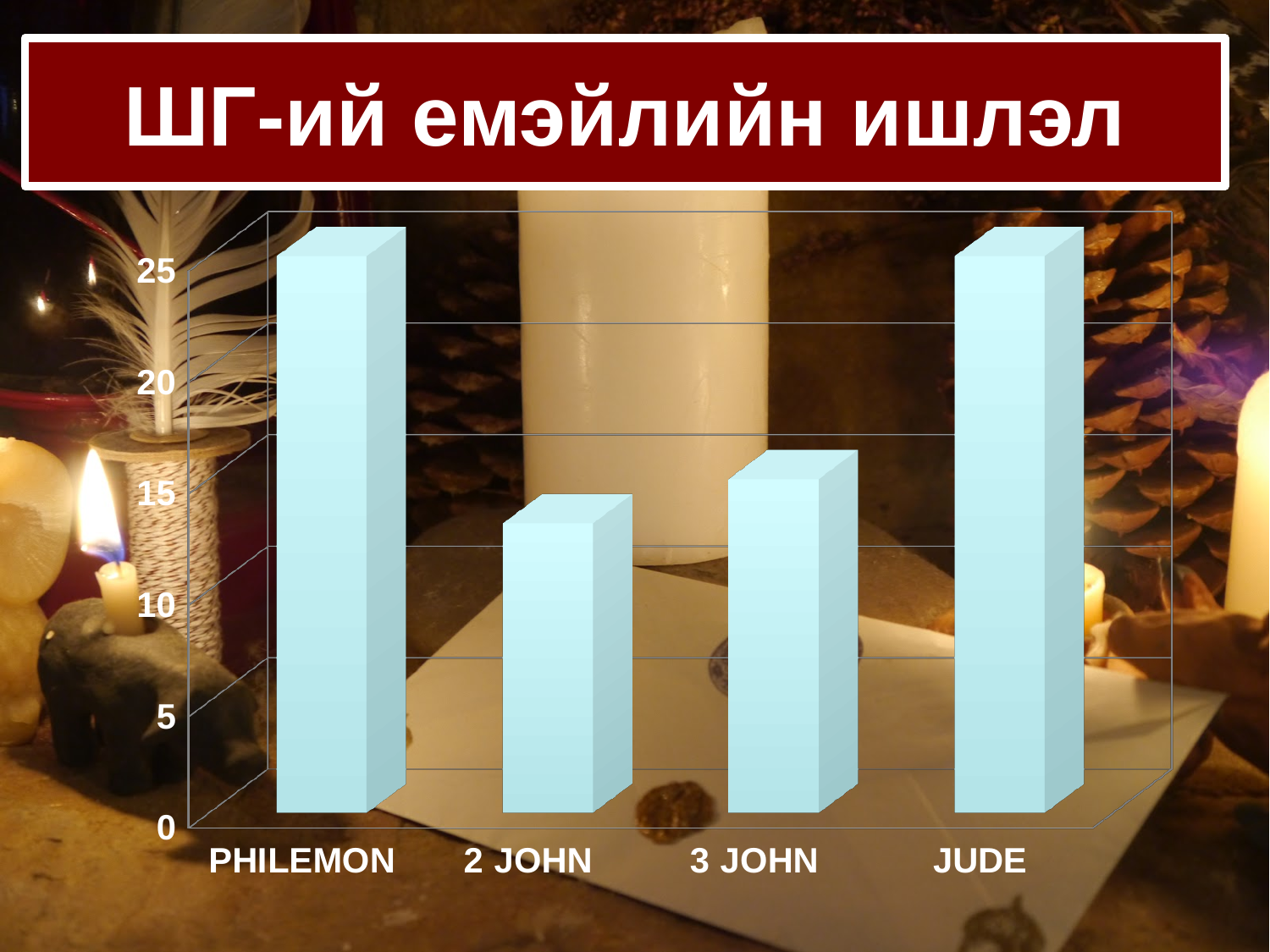
Is the value for 3 JOHN greater or less than 20? less Which is larger, the value for PHILEMON or the value for 2 JOHN? PHILEMON Is the value for JUDE greater or less than 20? greater Is the value for 2 JOHN greater or less than 10? greater How many categories are shown on the x axis of the chart? 4 Which category has the lowest bar in the chart? 2 JOHN Which is larger, the value for JUDE or the value for 3 JOHN? JUDE Which is larger, the value for 3 JOHN or the value for 2 JOHN? 3 JOHN What kind of chart is shown on the slide? bar chart What is the title shown above the chart on the slide? ШГ-ий емэйлийн ишлэл